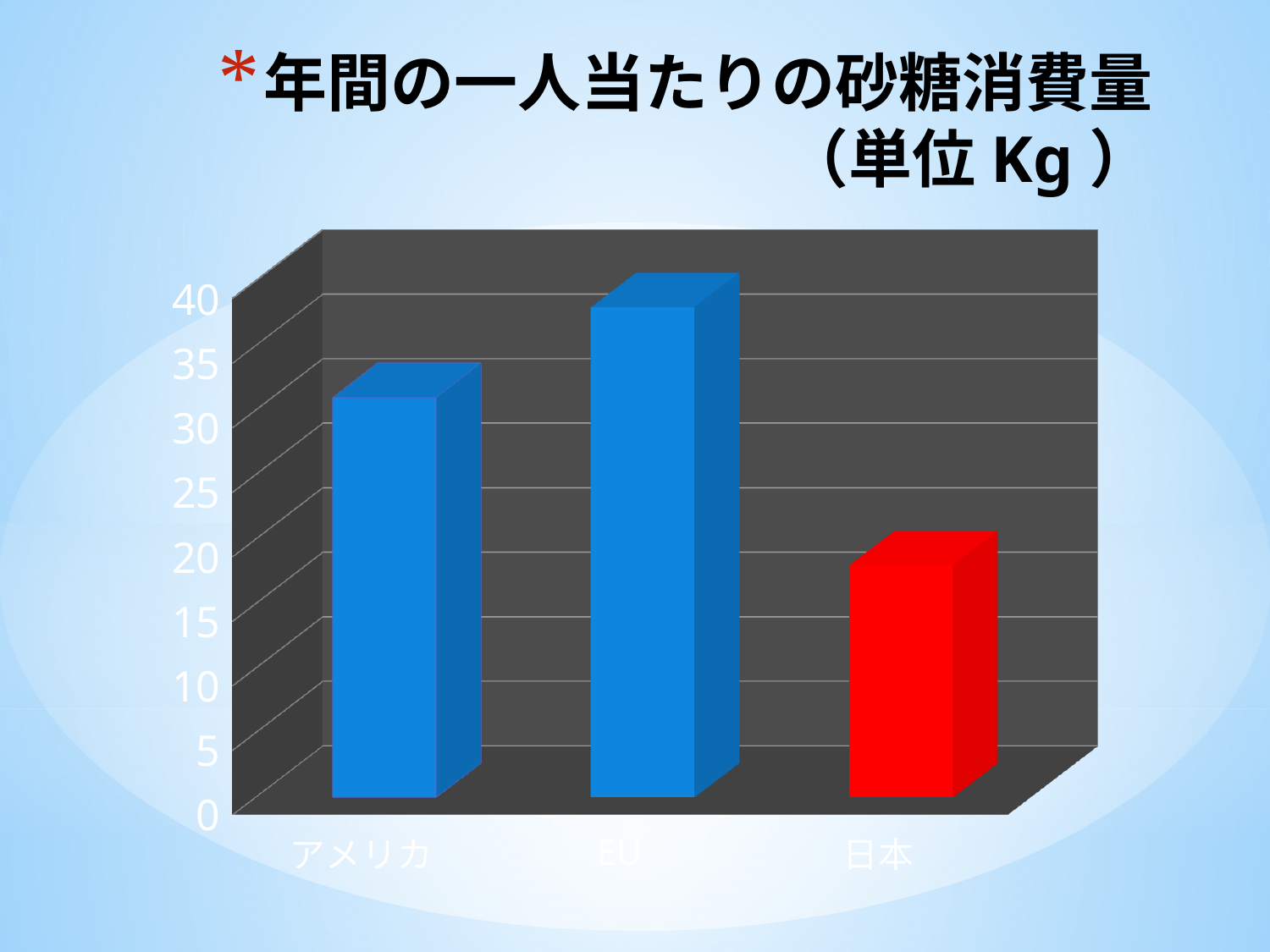
Is the value for 日本 greater or less than 25? less Which has a larger value, アメリカ or 日本? アメリカ Is the value for アメリカ greater or less than 30? greater Which has a larger value, アメリカ or EU? EU What colour is the bar for 日本? red Is the value for アメリカ greater or less than 35? less What kind of chart is shown on the slide? bar chart Which category has the highest value in the chart? EU How many categories are plotted in the chart? 3 Which category has the lowest value in the chart? 日本